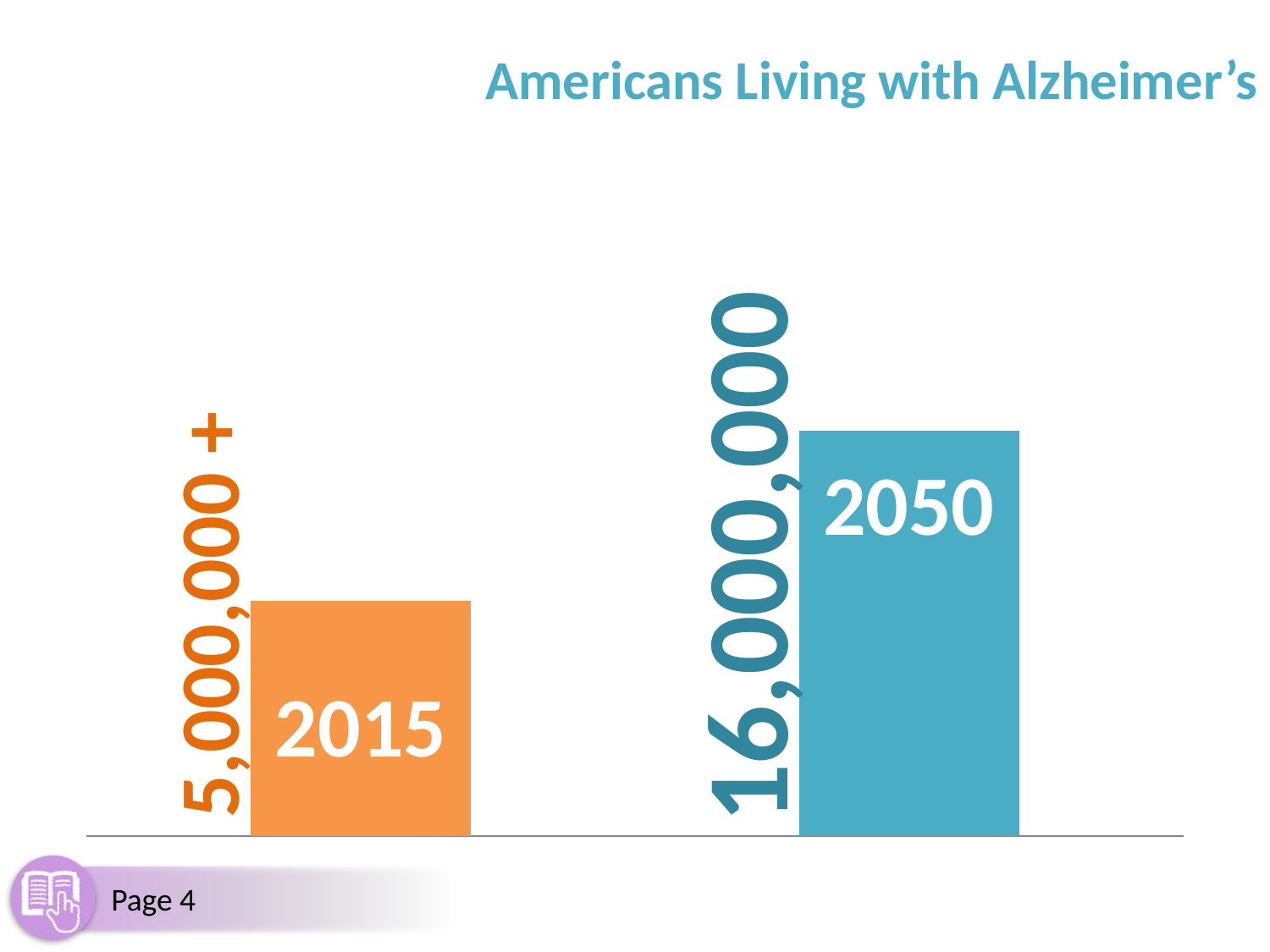
Which year has the lower value? 2015 Is the value for 2050 larger or smaller than the value for 2015? larger Which year has the higher value? 2050 How many bars are shown in the chart? 2 What colour is the bar for 2015? orange What is the value shown for 2015? 5,000,000 + What is the value shown for 2050? 16,000,000 Do the values rise or fall from 2015 to 2050? rise What is the title of the chart? Americans Living with Alzheimer's What kind of chart is shown on the slide? bar chart